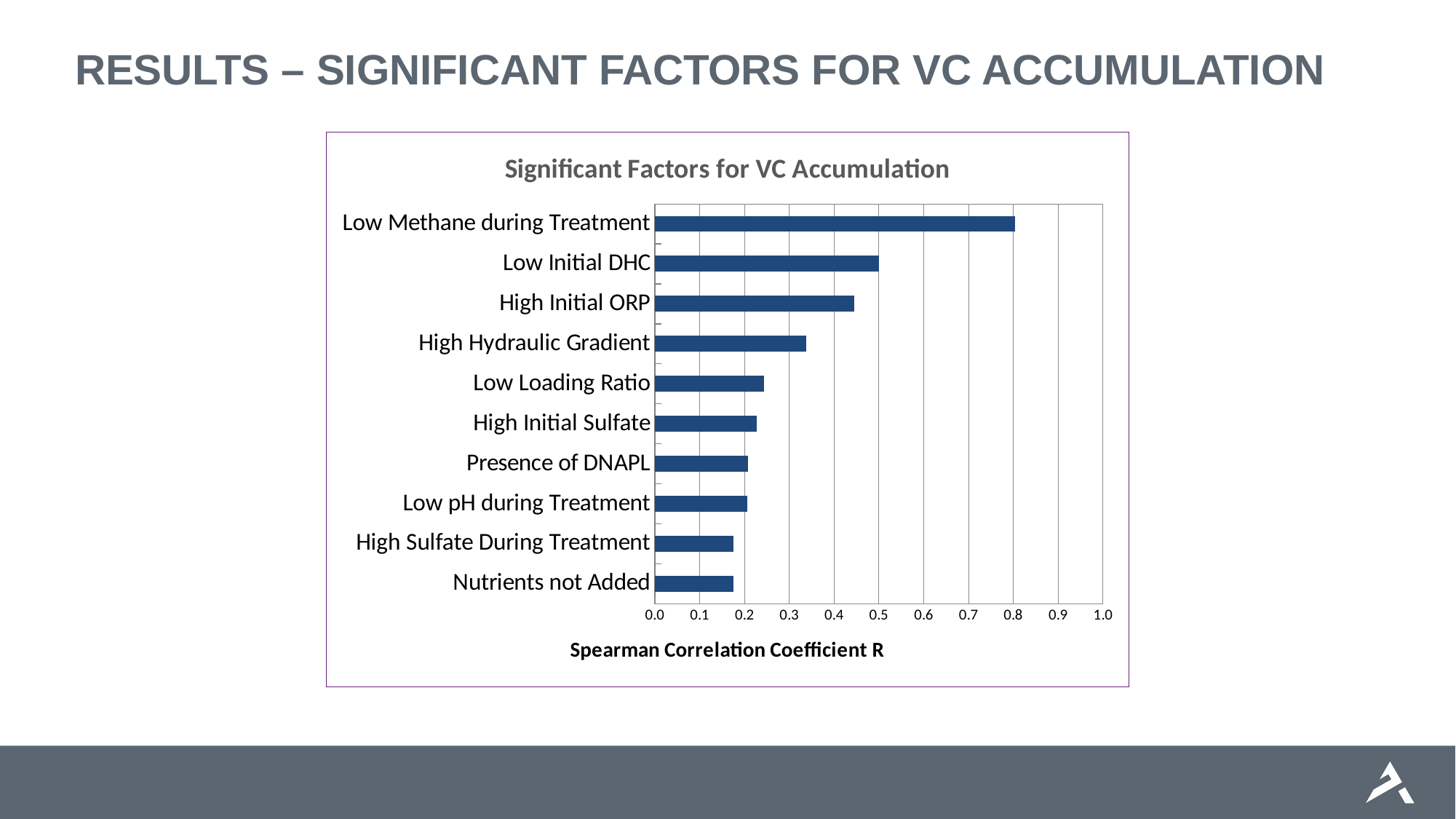
What kind of chart is shown on the slide? Bar chart What is the label of the horizontal axis? Spearman Correlation Coefficient R Which has a larger correlation coefficient, Low Initial DHC or High Hydraulic Gradient? Low Initial DHC Which has a larger correlation coefficient, Low Loading Ratio or High Sulfate During Treatment? Low Loading Ratio How many factors (categories) are plotted in the chart? 10 Is the value for High Hydraulic Gradient greater or less than 0.3? greater What is the title of the chart? Significant Factors for VC Accumulation Is the value for High Sulfate During Treatment greater or less than 0.2? less Is the value for Nutrients not Added greater or less than 0.2? less Which factor has the highest Spearman correlation coefficient? Low Methane during Treatment